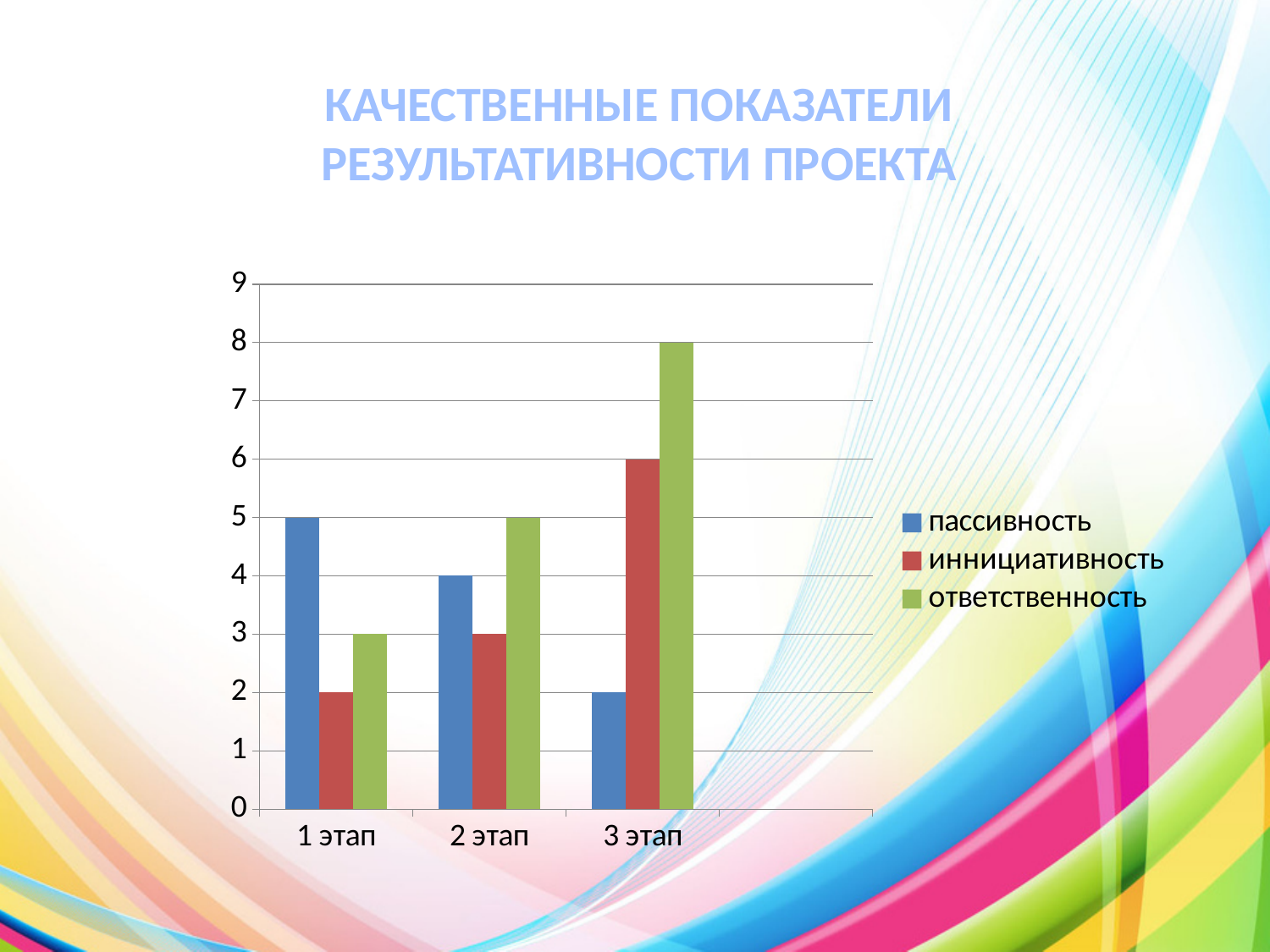
What is the title of the chart on the slide? КАЧЕСТВЕННЫЕ ПОКАЗАТЕЛИ РЕЗУЛЬТАТИВНОСТИ ПРОЕКТА How many categories are shown on the x axis? 3 Which is larger for 2 этап: пассивность or ответственность? ответственность What is the difference between ответственность and пассивность for 3 этап? 6 How many series does the legend list? 3 What is the value of ответственность for 3 этап? 8 Does пассивность rise or fall from 1 этап to 3 этап? fall What type of chart is shown on the slide? bar chart In which stage is ответственность highest? 3 этап What is the value of иннициативность for 2 этап? 3 What is the value of пассивность for 1 этап? 5 In which stage is пассивность lowest? 3 этап